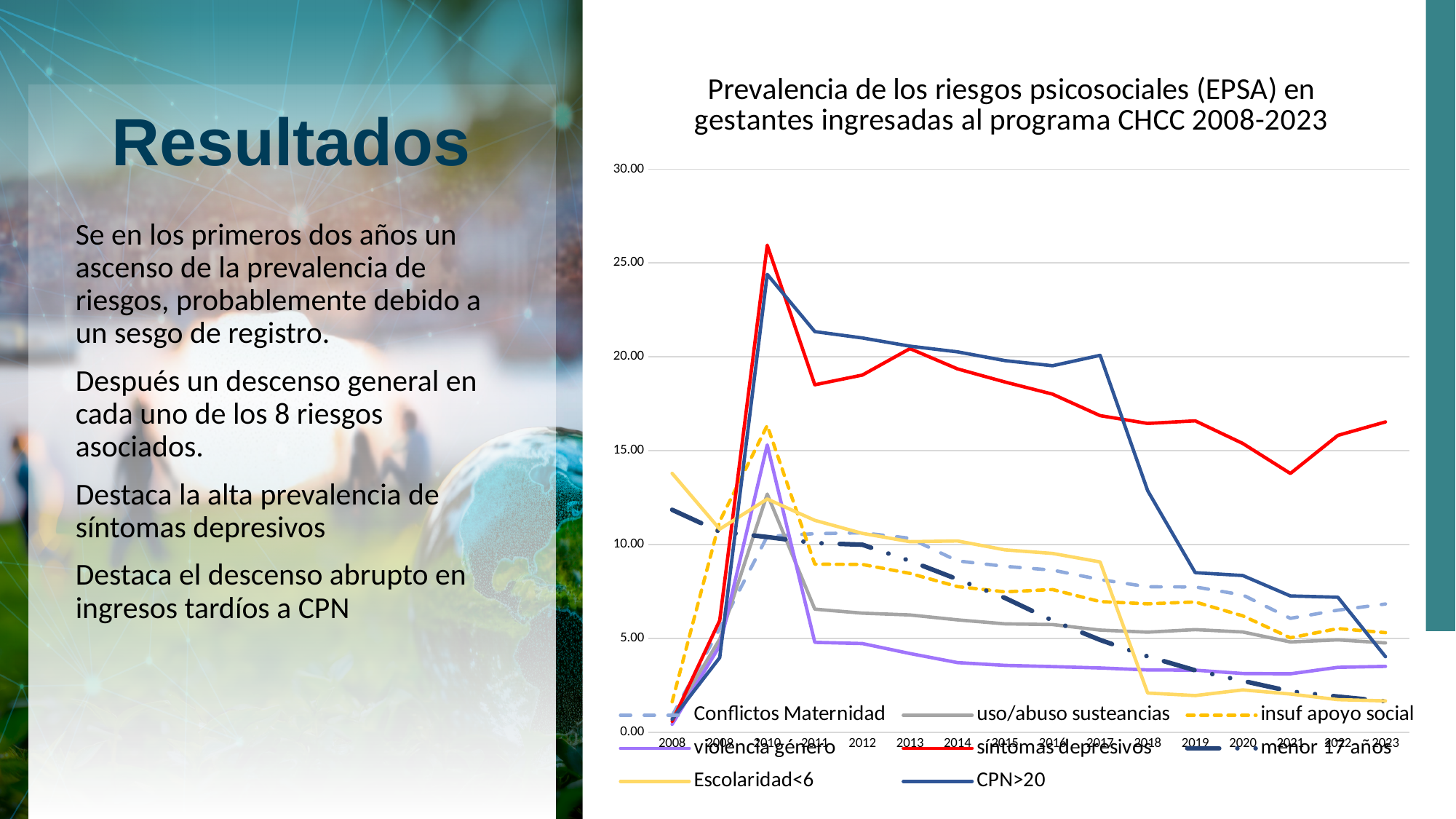
Is the value for CPN>20 in 2023 greater or less than 5? less What kind of chart is shown on the slide? line chart What is the title of the chart? Prevalencia de los riesgos psicosociales (EPSA) en gestantes ingresadas al programa CHCC 2008-2023 How many years are shown along the x axis? 16 How many series does the legend list? 8 Which series has the highest value in 2010? síntomas depresivos Is the value for síntomas depresivos in 2010 greater or less than 20? greater Which series is drawn in red? síntomas depresivos In 2017, which is larger: CPN>20 or síntomas depresivos? CPN>20 Which series has the highest value in 2023? síntomas depresivos Is the value for Escolaridad<6 in 2018 greater or less than 5? less Does the síntomas depresivos line rise or fall from 2010 to 2021? fall